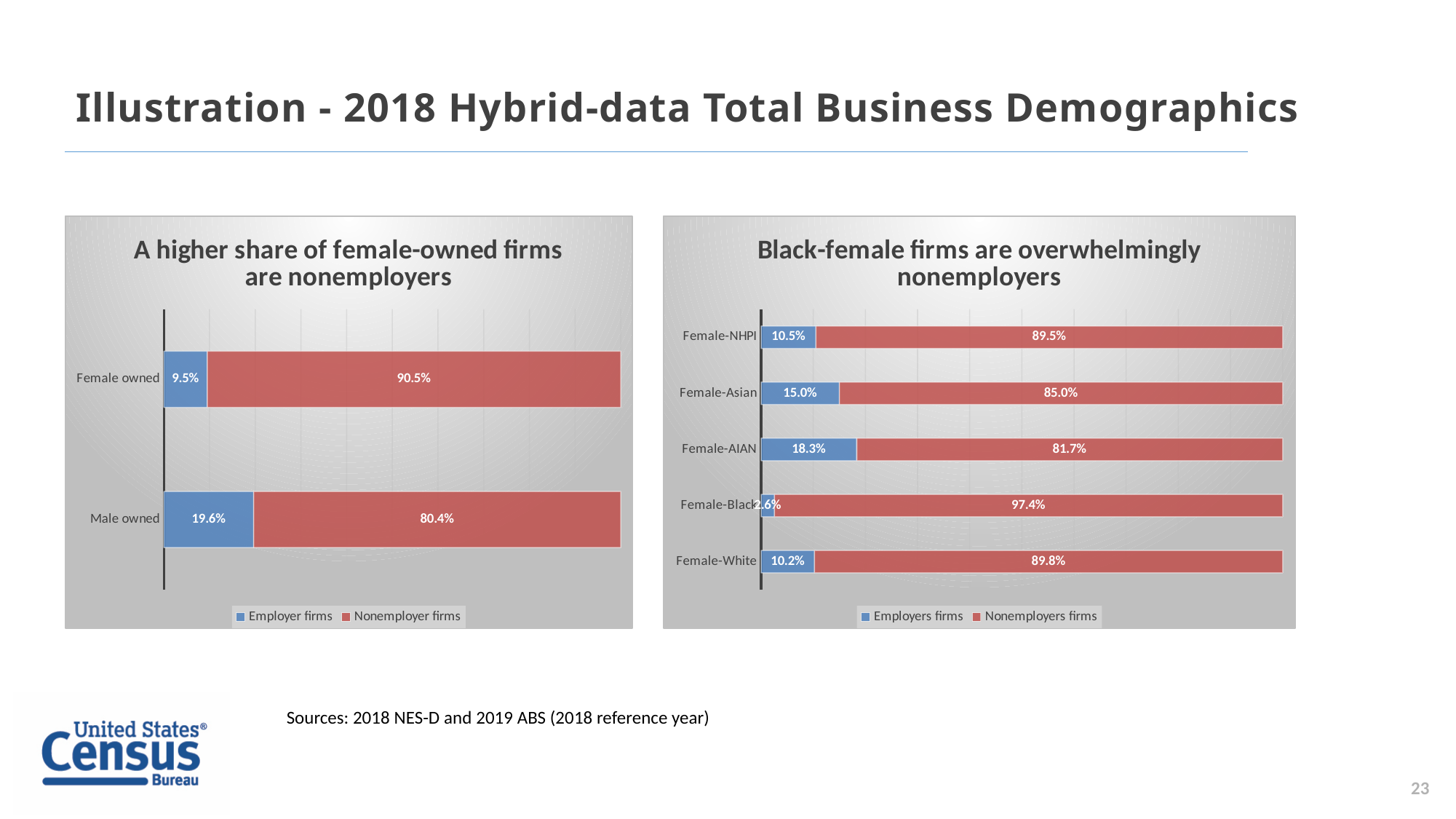
In the chart titled "Black-female firms are overwhelmingly nonemployers", what is the Nonemployers firms value for Female-Black? 97.4% What type of chart is the chart titled "A higher share of female-owned firms are nonemployers"? Stacked bar chart In the chart titled "A higher share of female-owned firms are nonemployers", what is the difference between the Employer firms values for Male owned and Female owned? 10.1% In the chart titled "Black-female firms are overwhelmingly nonemployers", how many categories are shown? 5 In the chart titled "A higher share of female-owned firms are nonemployers", how many categories are shown? 2 In the chart titled "A higher share of female-owned firms are nonemployers", what is the Nonemployer firms value for Female owned? 90.5% In the chart titled "Black-female firms are overwhelmingly nonemployers", which category has the lowest Nonemployers firms value? Female-AIAN In the chart titled "Black-female firms are overwhelmingly nonemployers", which has a larger Employers firms value, Female-Asian or Female-White? Female-Asian In the chart titled "Black-female firms are overwhelmingly nonemployers", which category has the highest Employers firms value? Female-AIAN In the chart titled "Black-female firms are overwhelmingly nonemployers", how many series does the legend list? 2 In the chart titled "A higher share of female-owned firms are nonemployers", what is the Employer firms value for Male owned? 19.6% In the chart titled "Black-female firms are overwhelmingly nonemployers", what is the Employers firms value for Female-AIAN? 18.3%